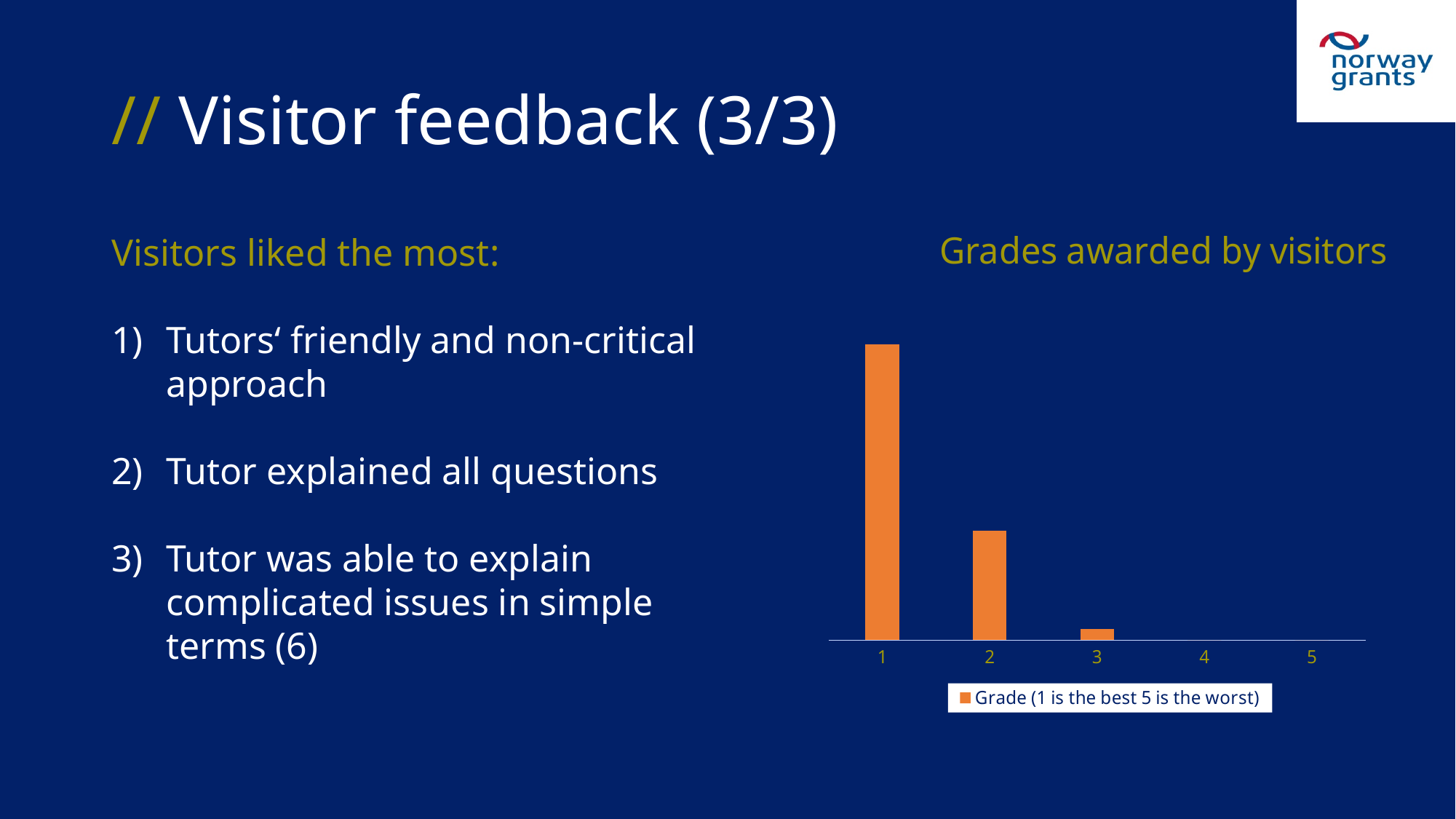
How many series does the chart legend list? 1 Is the bar for grade 1 taller or shorter than the bar for grade 2? taller Do the bar heights rise or fall as the grade goes from 1 to 5? fall What is the title of the chart on the slide? Grades awarded by visitors Among grades 1, 2 and 3, which has the shortest bar in the chart? 3 Which has the larger bar in the chart, grade 2 or grade 3? grade 2 How many grade categories are shown on the x axis of the chart? 5 What kind of chart is shown under "Grades awarded by visitors"? bar chart Which grade received the tallest bar in the "Grades awarded by visitors" chart? 1 What is the legend entry of the chart? Grade (1 is the best 5 is the worst)